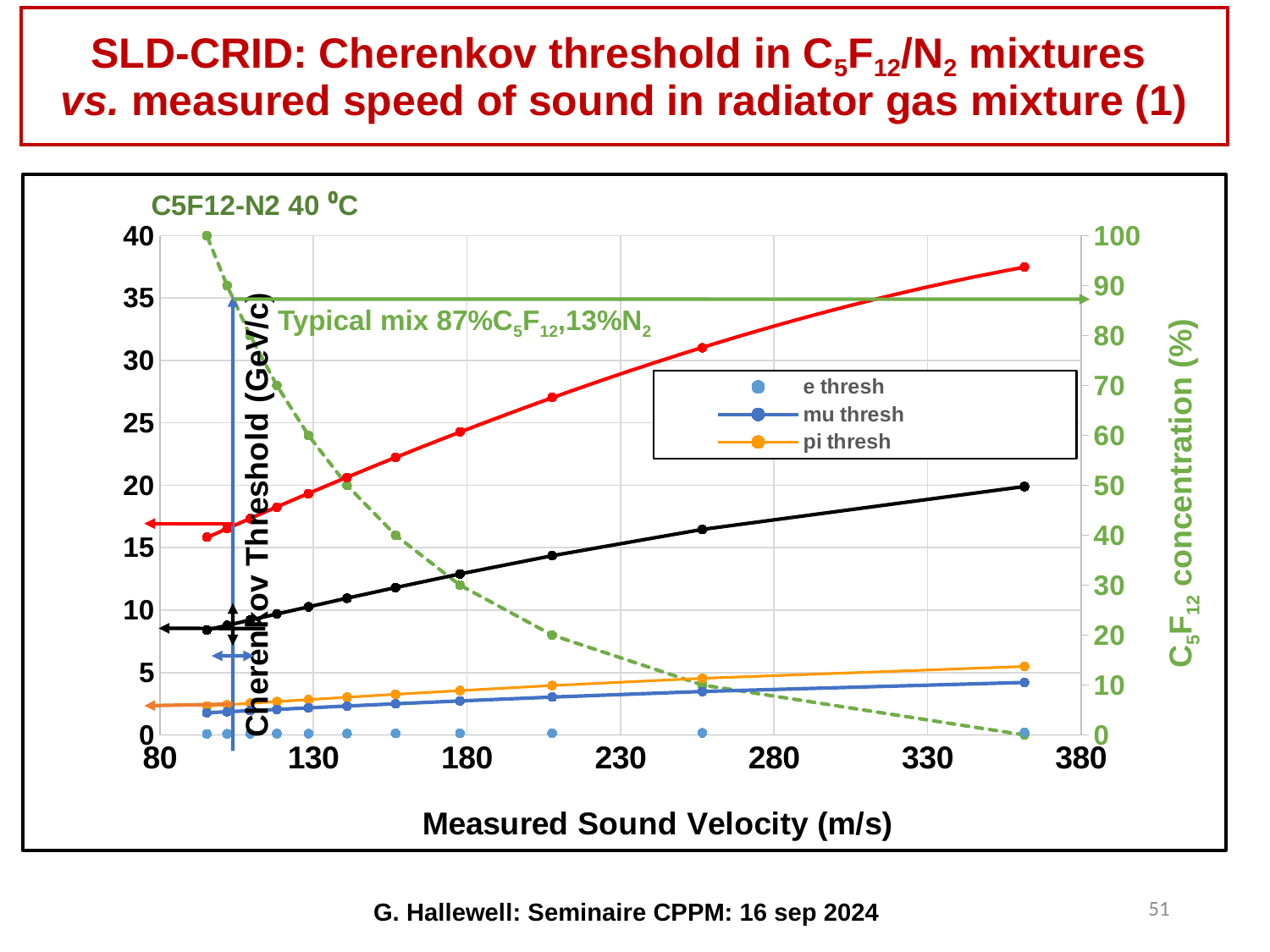
Which series are listed in the chart legend? e thresh, mu thresh, pi thresh Does the green dashed C5F12 concentration curve rise or fall as measured sound velocity increases? falls Does the mu thresh series rise or fall as measured sound velocity increases? rises Is the e thresh value at the highest sound velocity plotted greater or less than 5 GeV/c? less Is the pi thresh value at the highest sound velocity plotted (about 360 m/s) greater or less than 10 GeV/c? less Does the pi thresh series rise or fall as measured sound velocity increases? rises What kind of chart is shown on the slide? line chart What is the title of the x axis of the chart? Measured Sound Velocity (m/s) At the highest sound velocity plotted, which is larger, the pi thresh value or the mu thresh value? pi thresh How many series does the chart legend list? 3 Is the mu thresh value at the highest sound velocity plotted (about 360 m/s) greater or less than 5 GeV/c? less At the highest sound velocity plotted, which is larger, the pi thresh value or the e thresh value? pi thresh